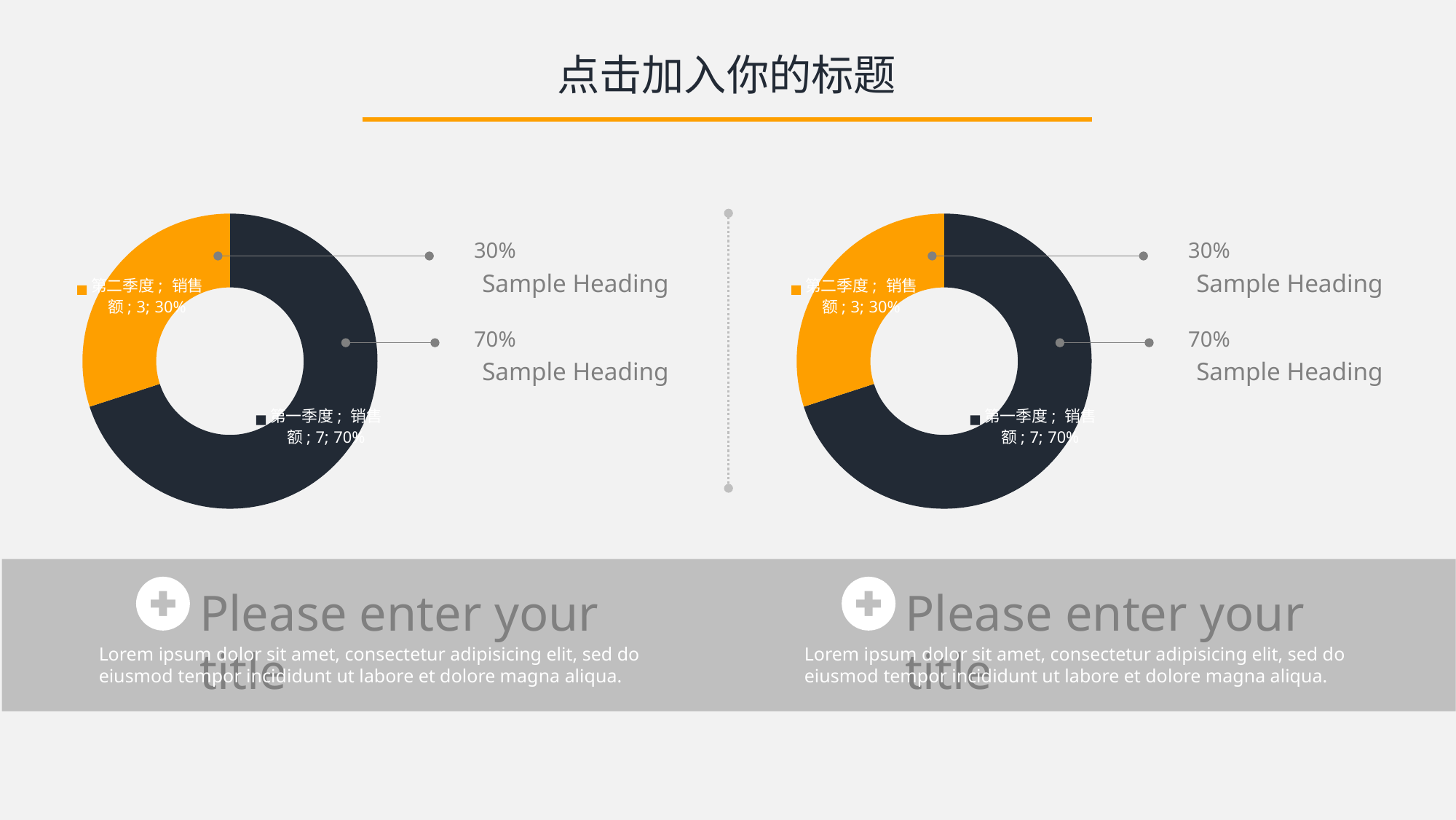
On the left chart, what is the 销售额 value for 第二季度? 3 On the left chart, which category has the largest slice? 第一季度 On the right chart, which category has the smallest slice? 第二季度 On the left chart, what colour is the 第二季度 slice? Orange On the right chart, what is the difference between the 销售额 values of 第一季度 and 第二季度? 4 On the right chart, what is the 销售额 value for 第二季度? 3 On the left chart, what is the 销售额 value for 第一季度? 7 On the left chart, what share of the doughnut does 第二季度 take? 30% On the left chart, how many slices does the doughnut have? 2 On the right chart, which is larger, the value for 第一季度 or 第二季度? 第一季度 On the left chart, what kind of chart is shown? Doughnut chart On the right chart, what share of the doughnut does 第一季度 take? 70%